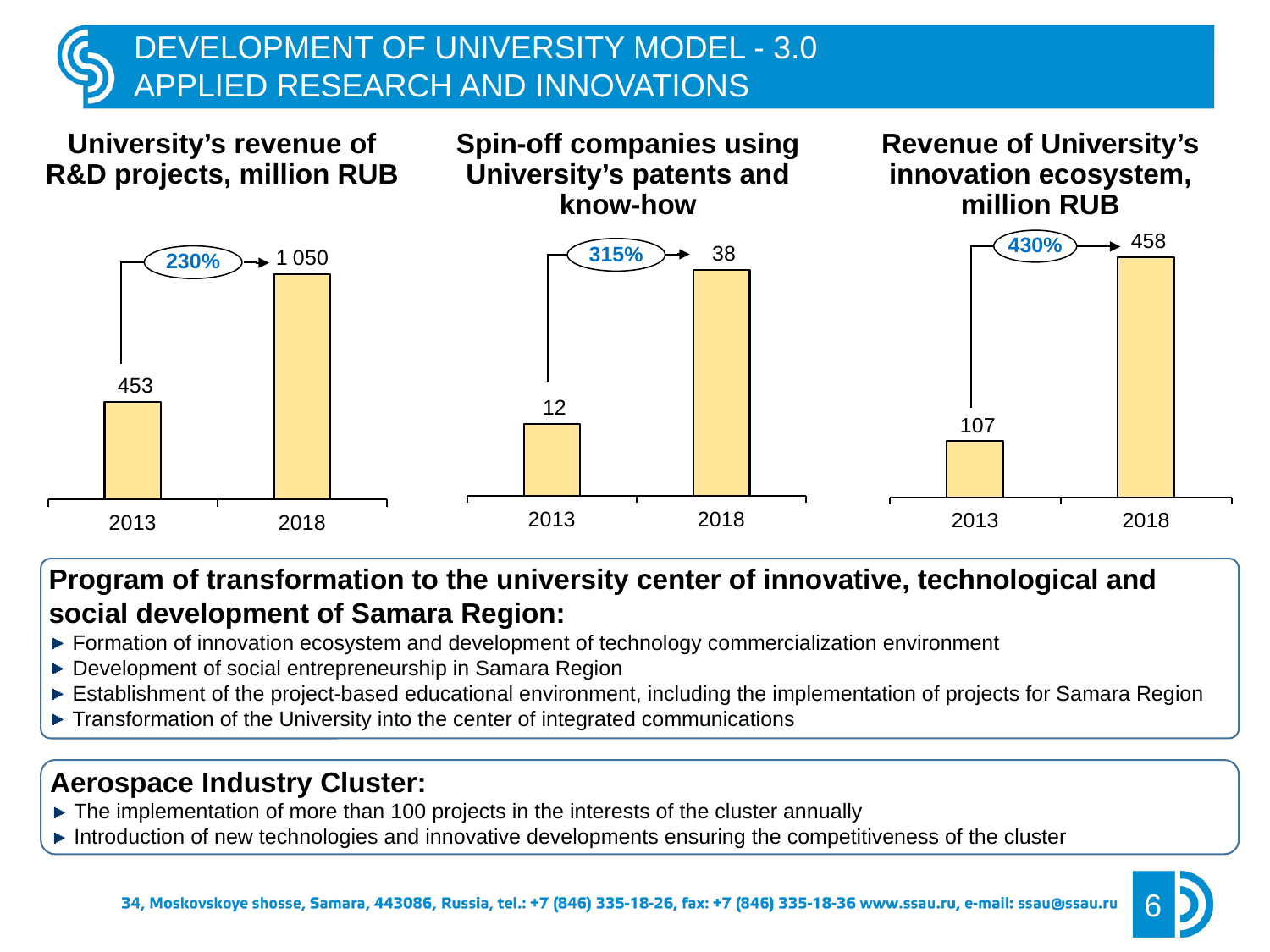
What kind of chart is the 'Revenue of University's innovation ecosystem, million RUB' chart? Bar chart In the 'University's revenue of R&D projects, million RUB' chart, what is the value for 2013? 453 In the 'Spin-off companies using University's patents and know-how' chart, what is the value for 2013? 12 In the 'University's revenue of R&D projects, million RUB' chart, what percentage growth is shown in the callout between 2013 and 2018? 230% In the 'Spin-off companies using University's patents and know-how' chart, what is the difference between the 2018 and 2013 values? 26 In the 'Revenue of University's innovation ecosystem, million RUB' chart, what is the value for 2013? 107 How many categories are shown on the x axis of the 'Spin-off companies using University's patents and know-how' chart? 2 In the 'Revenue of University's innovation ecosystem, million RUB' chart, what is the difference between the 2018 and 2013 values? 351 In the 'University's revenue of R&D projects, million RUB' chart, what is the value for 2018? 1 050 In the 'Revenue of University's innovation ecosystem, million RUB' chart, what is the value for 2018? 458 In the 'Spin-off companies using University's patents and know-how' chart, what is the value for 2018? 38 In the 'University's revenue of R&D projects, million RUB' chart, which year has the higher value? 2018